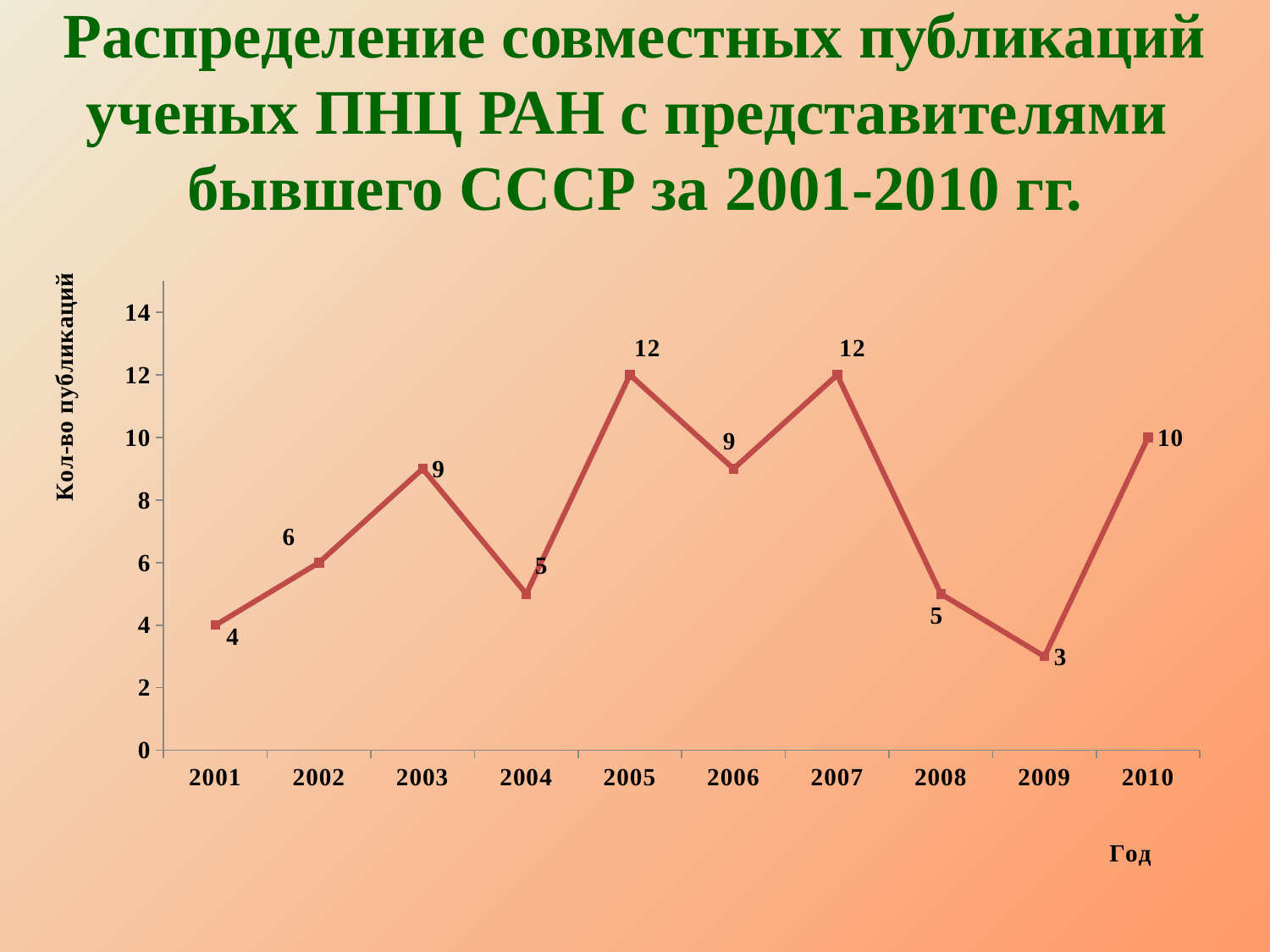
Which year has the lowest number of publications? 2009 Which is larger, the value for 2003 or the value for 2004? 2003 What type of chart is shown on the slide? line chart What is the highest value plotted on the chart? 12 What is the value for 2001? 4 What is the difference between the values for 2005 and 2006? 3 How many years are plotted on the x axis? 10 What is the value for 2009? 3 What is the difference between the values for 2010 and 2009? 7 What is the label of the y axis? Кол-во публикаций Does the value rise or fall from 2007 to 2008? fall How many publications were there in 2005? 12